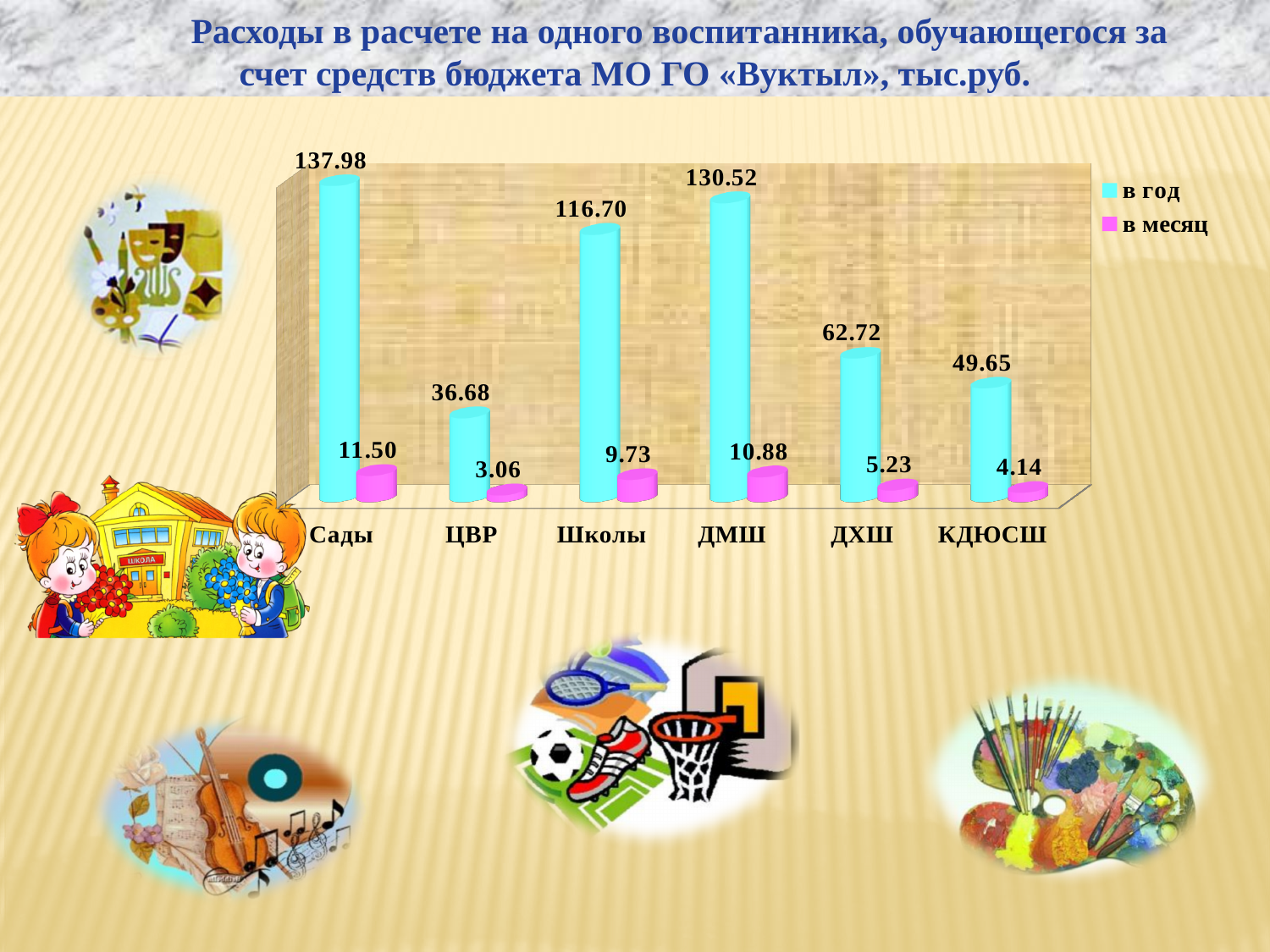
What is the difference between the "в год" values for Сады and ДМШ? 7.46 Which is larger, the "в год" value for Школы or for ДМШ? ДМШ Which colour represents the "в месяц" series in the legend? pink Which category has the lowest "в месяц" value? ЦВР Which category has the highest "в год" value? Сады How many series does the legend list? 2 What is the value of "в месяц" for ДМШ? 10.88 What is the value of "в год" for КДЮСШ? 49.65 What is the value of "в год" for Сады? 137.98 What kind of chart is shown on the slide? bar chart How many categories are shown on the x axis? 6 What is the difference between the "в месяц" values for Сады and ЦВР? 8.44